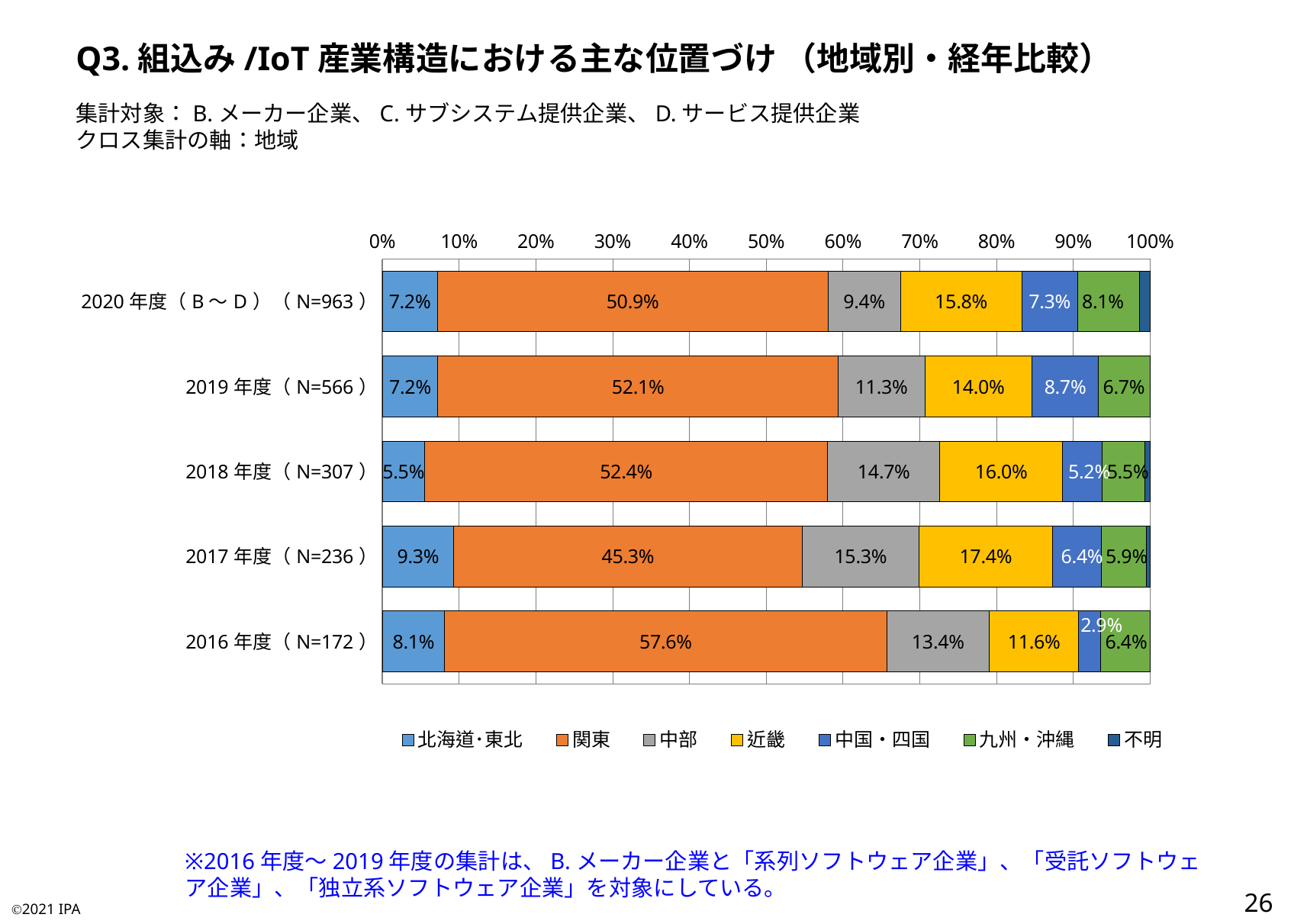
Which series is shown in orange in the legend? 関東 What is the value for 中国・四国 in 2016年度 (N=172)? 2.9% What is the value for 関東 in 2020年度 (N=963)? 50.9% What is the difference between the 関東 values for 2016年度 and 2017年度? 12.3% What kind of chart is shown on the slide? Stacked bar chart How many years (bars) are shown in the chart? 5 In which year is the 関東 share the highest? 2016年度 (N=172) Which is larger, the 近畿 value for 2019年度 or for 2018年度? 2018年度 (16.0%) What is the value for 中部 in 2018年度 (N=307)? 14.7% How many series does the legend list? 7 In which year is the 北海道･東北 share the lowest? 2018年度 (N=307) What is the value for 近畿 in 2017年度 (N=236)? 17.4%